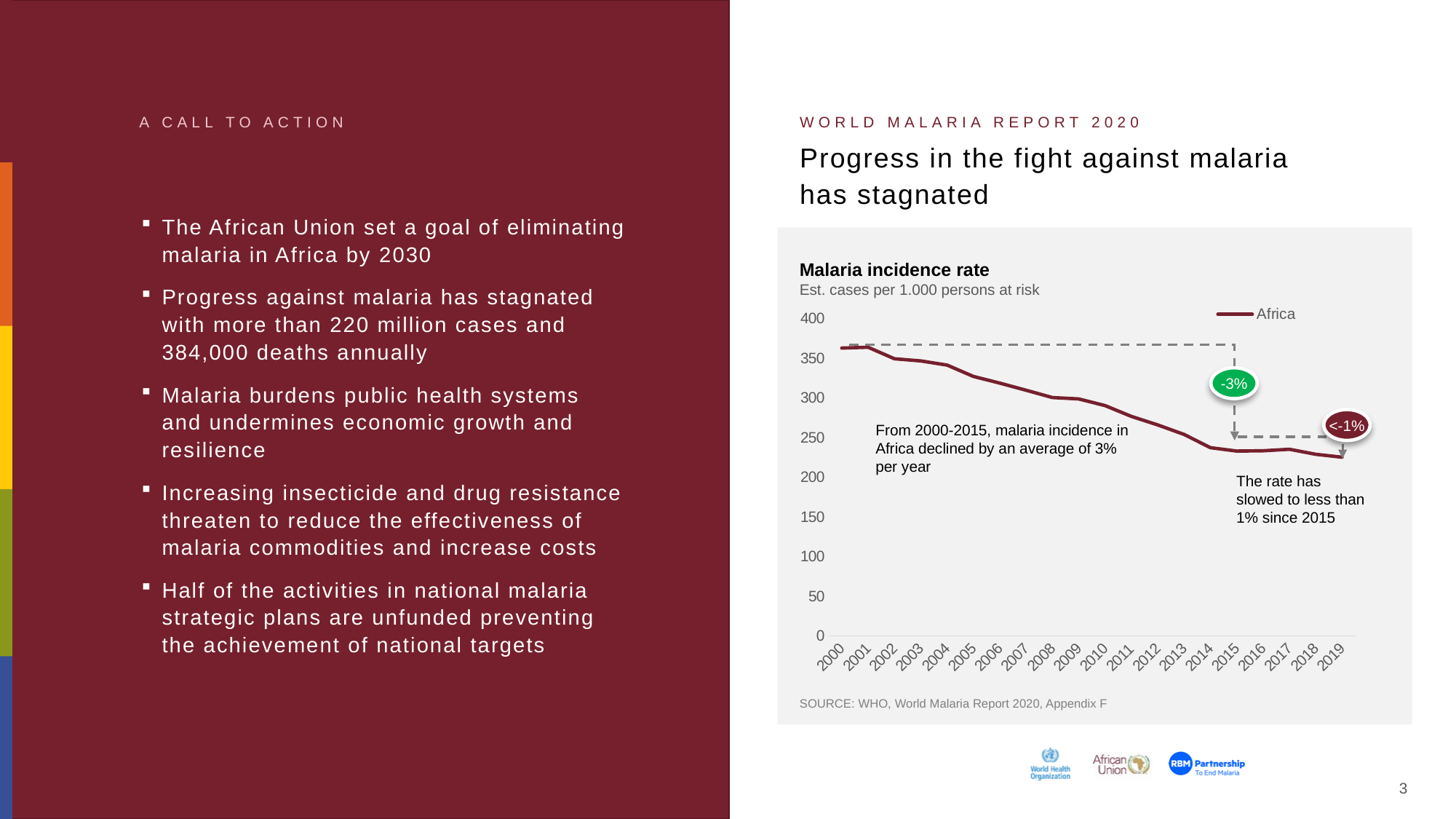
Is the value for Africa in 2005 greater or less than 300? greater Is the value for Africa in 2019 greater or less than 250? less What is the name of the series shown in the chart legend? Africa How many years are plotted along the x axis of the chart? 20 What is the title of the chart? Malaria incidence rate How many series does the chart legend list? 1 Is the value for Africa in 2012 greater or less than 300? less Does the malaria incidence rate for Africa rise or fall from 2000 to 2019? fall Which year has the lowest malaria incidence rate in the chart? 2019 What kind of chart is shown on the slide? line chart